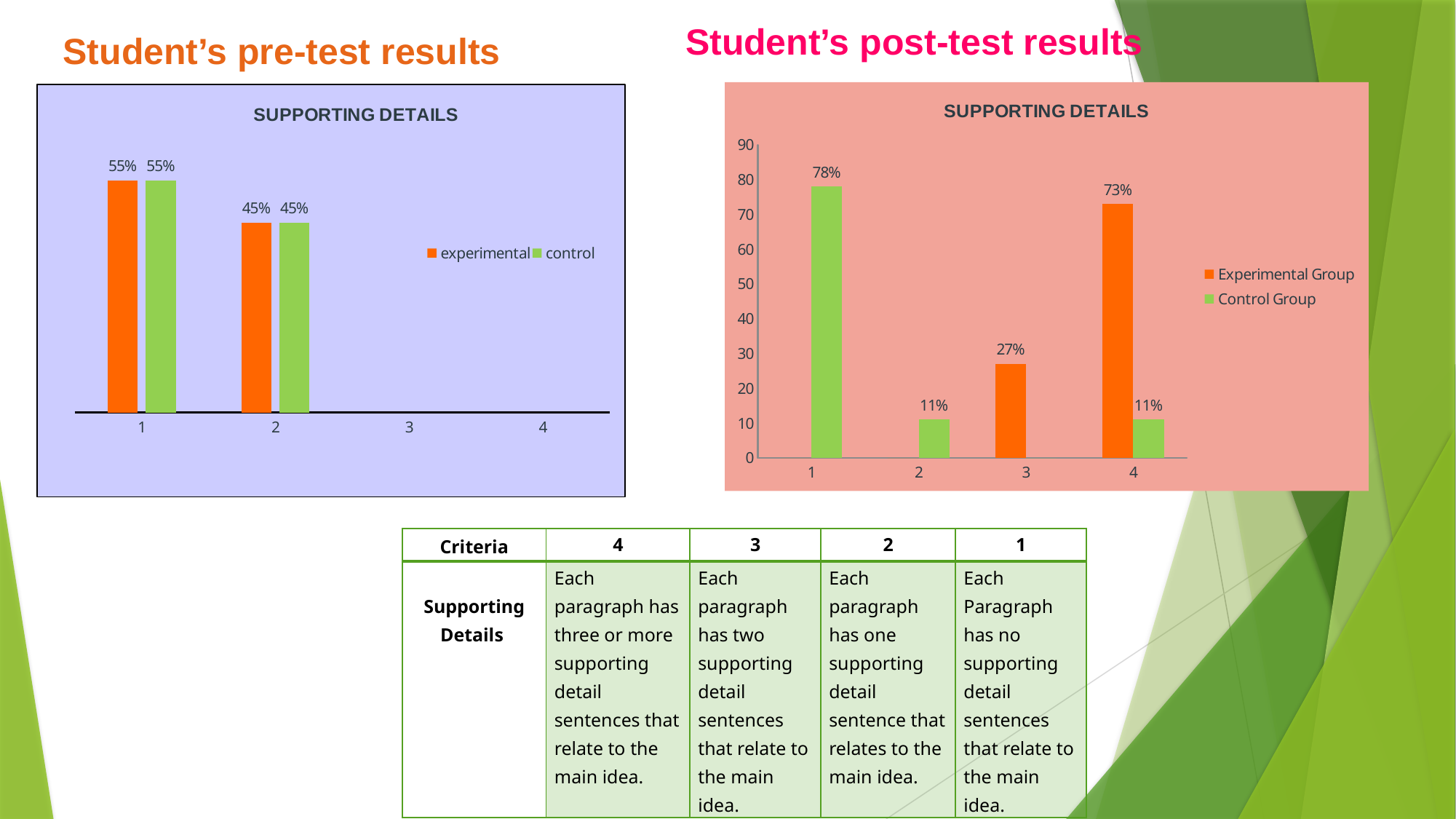
In the post-test results chart on the right, what is the value for the Experimental Group at category 4? 73% In the post-test results chart on the right, what is the value for the Experimental Group at category 3? 27% In the post-test results chart on the right, what is the difference between the Experimental Group value at category 4 and the Control Group value at category 4? 62% In the post-test results chart on the right, what is the value for the Control Group at category 1? 78% In the post-test results chart on the right, which is larger: the Control Group value at category 1 or the Experimental Group value at category 4? Control Group at category 1 In the post-test results chart on the right, is the Experimental Group value at category 3 greater or less than 30? less In the post-test results chart on the right, which category has the highest Control Group value? 1 What is the title of the post-test results chart on the right? SUPPORTING DETAILS How many series does the legend of the post-test results chart on the right list? 2 In the pre-test results chart on the left, what is the value for the experimental series at category 1? 55% In the pre-test results chart on the left, what is the value for the control series at category 2? 45% What kind of chart is the pre-test results chart on the left? bar chart